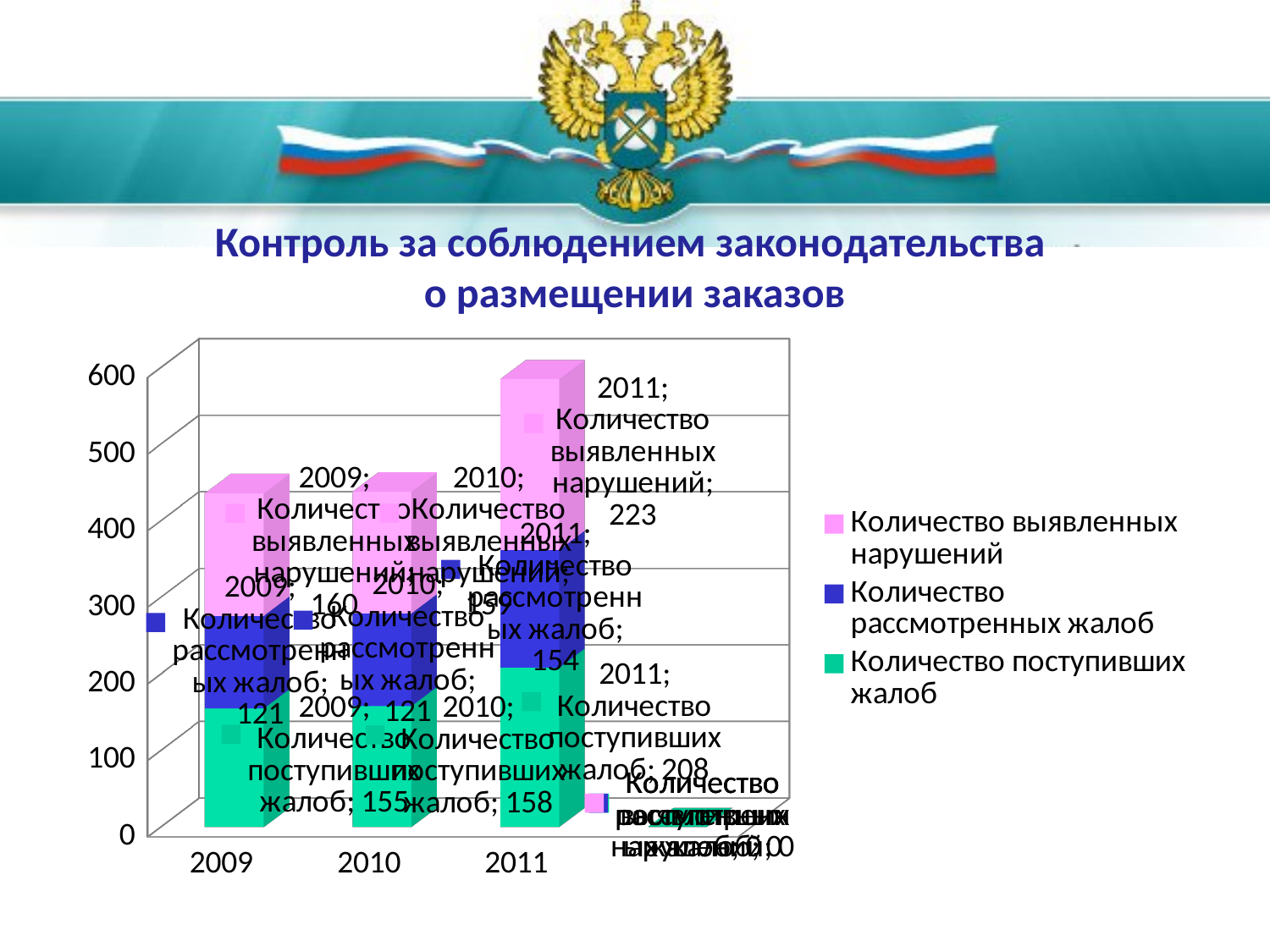
What kind of chart is shown on the slide? Bar chart What is the value of Количество выявленных нарушений for 2009? 160 How many series does the legend list? 3 In which year is Количество выявленных нарушений highest? 2011 What is the difference between Количество поступивших жалоб in 2011 and in 2010? 50 Which is larger: Количество рассмотренных жалоб in 2011 or in 2009? 2011 What is the value of Количество поступивших жалоб for 2010? 158 What is the value of Количество рассмотренных жалоб for 2009? 121 Does Количество поступивших жалоб rise or fall from 2009 to 2011? Rise What is the total of the stacked bar for 2011? 585 What is the value of Количество выявленных нарушений for 2011? 223 What is the difference between Количество выявленных нарушений in 2011 and in 2009? 63